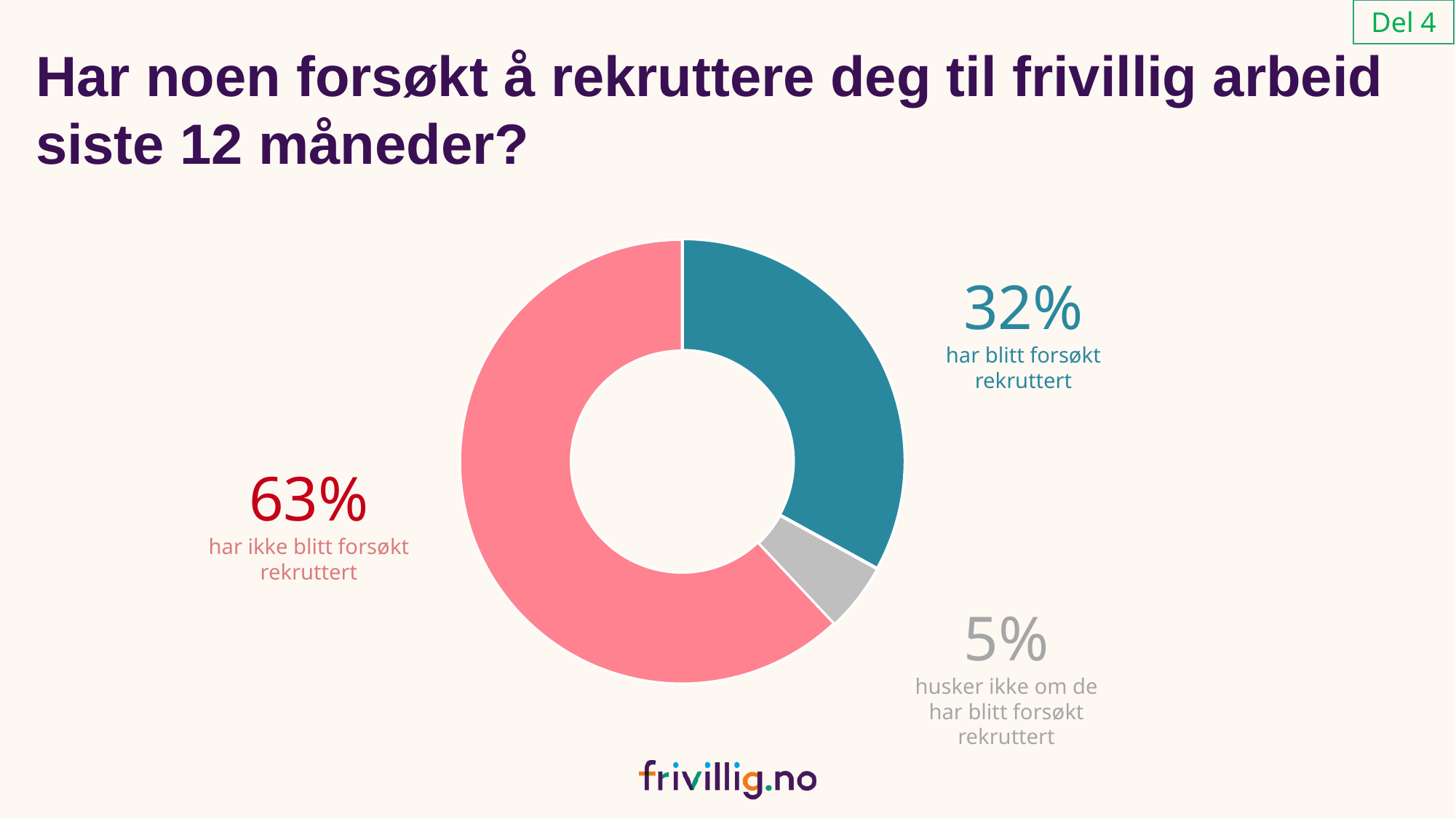
What share of respondents do not remember whether they have been attempted recruited ("husker ikke om de har blitt forsøkt rekruttert")? 5% How many categories are shown in the chart? 3 What is the title of the slide? Har noen forsøkt å rekruttere deg til frivillig arbeid siste 12 måneder? Which is larger: the share for "har blitt forsøkt rekruttert" or the share for "husker ikke om de har blitt forsøkt rekruttert"? har blitt forsøkt rekruttert Which category has the smallest share in the chart? husker ikke om de har blitt forsøkt rekruttert What is the difference in percentage points between "har ikke blitt forsøkt rekruttert" and "har blitt forsøkt rekruttert"? 31 percentage points What colour is the segment for "har blitt forsøkt rekruttert"? Teal (blue-green) What share of respondents have been attempted recruited ("har blitt forsøkt rekruttert")? 32% What share of respondents have not been attempted recruited ("har ikke blitt forsøkt rekruttert")? 63% Which category has the largest share in the chart? har ikke blitt forsøkt rekruttert What is the combined share of "har blitt forsøkt rekruttert" and "husker ikke om de har blitt forsøkt rekruttert"? 37% What kind of chart is shown on the slide? Pie chart (donut)